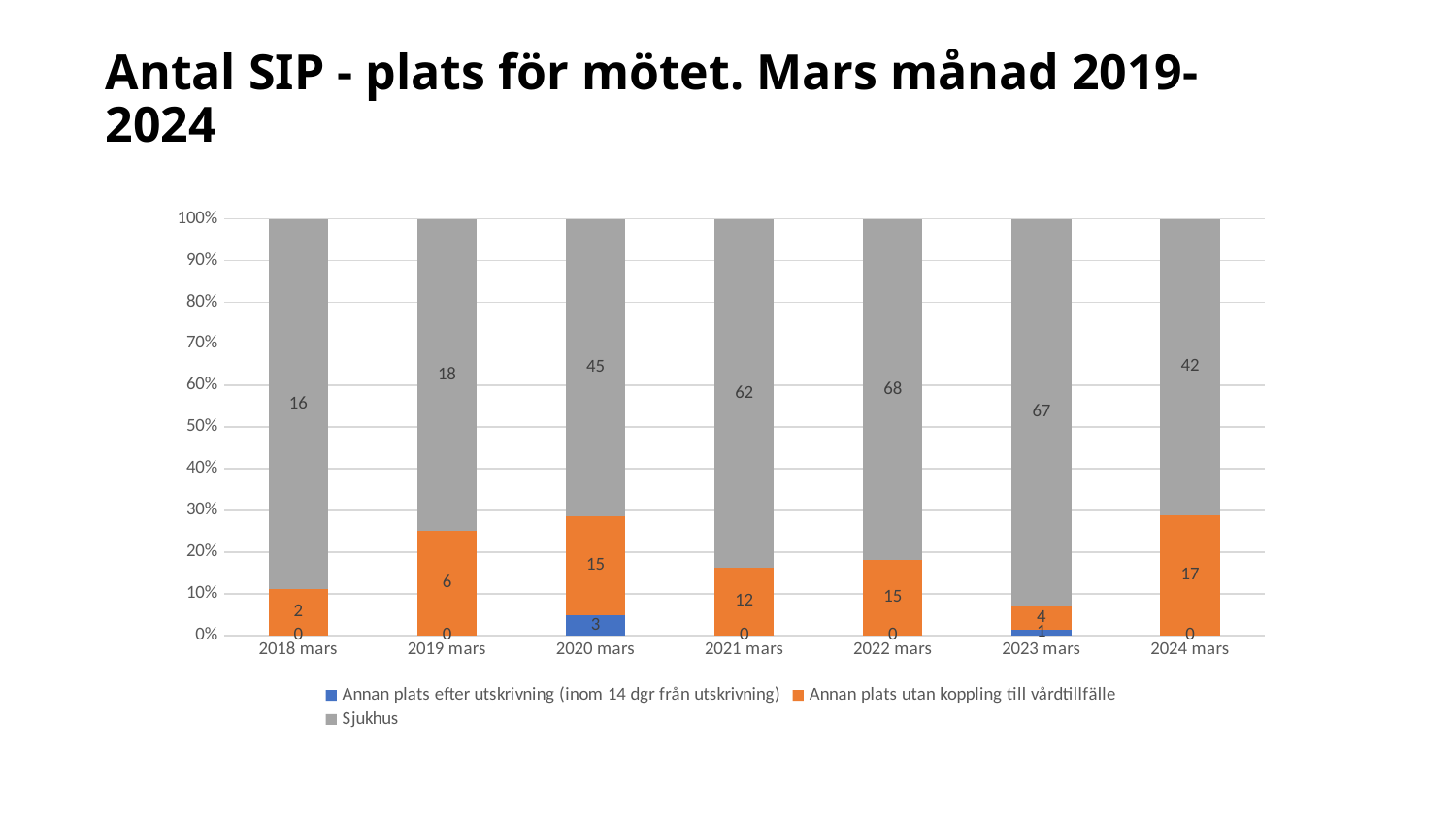
What is the value for Annan plats utan koppling till vårdtillfälle in 2024 mars? 17 How many series does the legend list? 3 In which category is the Sjukhus value lowest? 2018 mars What is the value for Annan plats efter utskrivning (inom 14 dgr från utskrivning) in 2020 mars? 3 What is the total of the three values in the 2020 mars bar? 63 Which colour represents Sjukhus in the chart? Grey In which category is the Sjukhus value highest? 2022 mars How many categories are shown on the x axis? 7 What kind of chart is shown on the slide? Stacked bar chart What is the value for Sjukhus in 2022 mars? 68 Which is larger: the Annan plats utan koppling till vårdtillfälle value for 2019 mars or for 2021 mars? 2021 mars What is the difference between the Sjukhus values for 2021 mars and 2024 mars? 20